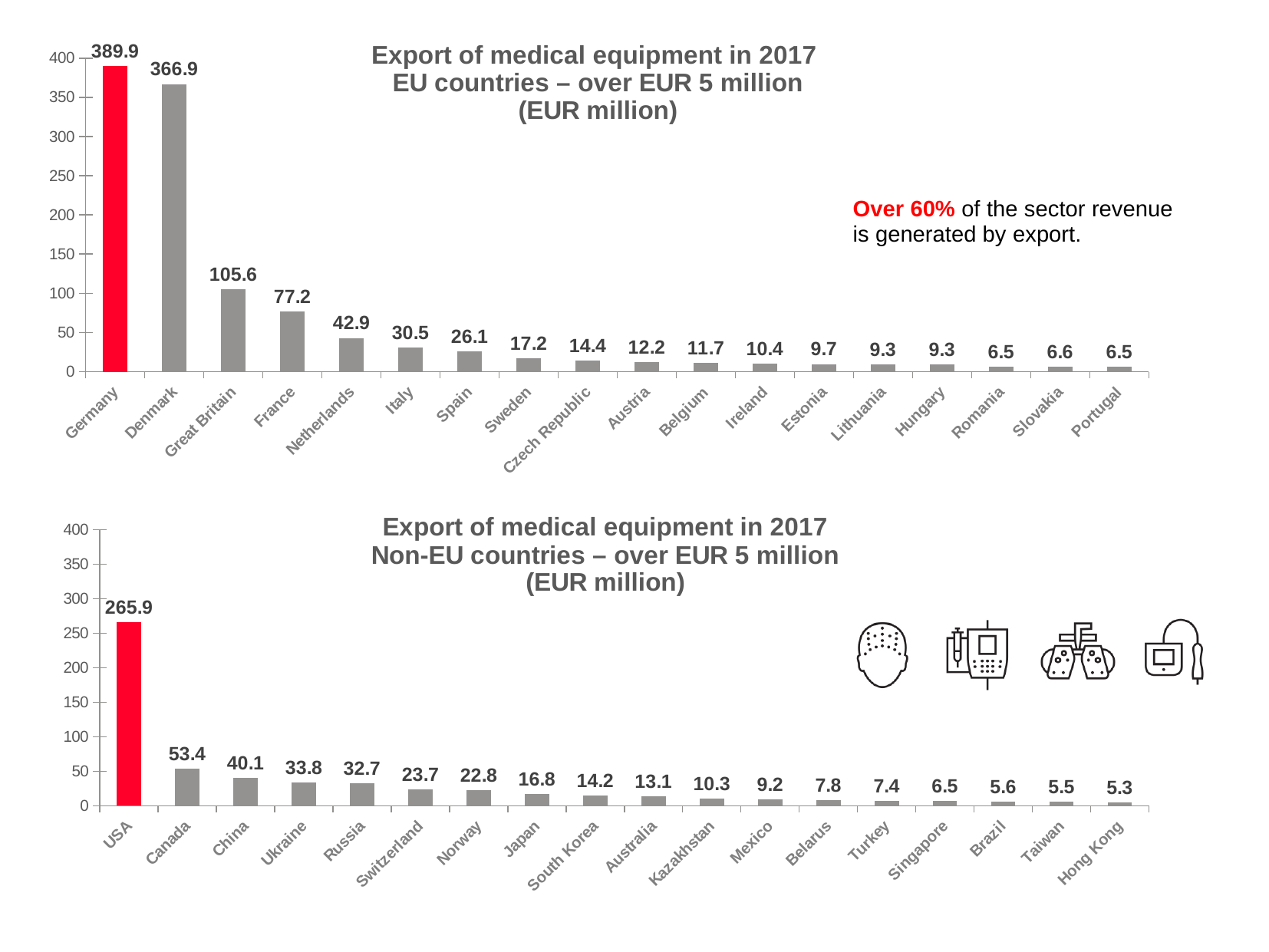
In the bottom chart (Non-EU countries), how many countries are shown? 18 In the bottom chart (Non-EU countries), what is the difference between the values for USA and Canada? 212.5 In the bottom chart (Non-EU countries), which is larger, the value for China or the value for Ukraine? China What type of chart is the top chart (EU countries)? Bar chart In the bottom chart (Non-EU countries), do the values rise or fall from left to right? Fall In the bottom chart (Non-EU countries), what is the export value for Canada? 53.4 In the top chart (EU countries), what is the export value for Great Britain? 105.6 In the top chart (EU countries), what is the difference between the values for Germany and Denmark? 23 In the top chart (EU countries), which country has the highest export value? Germany In the top chart (EU countries), how many countries are shown? 18 In the bottom chart (Non-EU countries), which country has the lowest export value? Hong Kong In the top chart (EU countries), what is the export value for Germany? 389.9